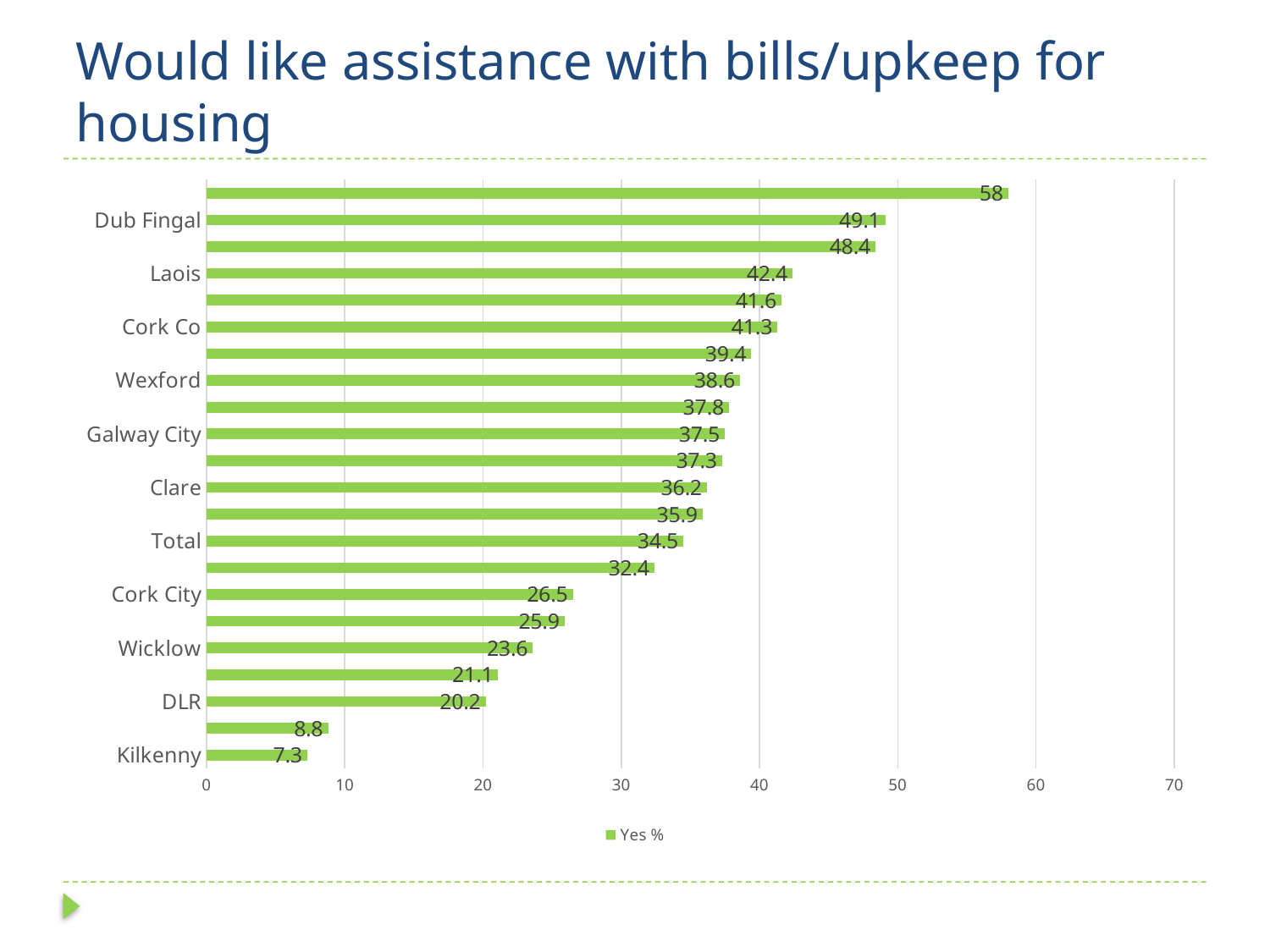
What is the value for Dub Fingal? 49.1 What is the value for Kilkenny? 7.3 Which labelled category has the lowest value? Kilkenny What is the largest value shown on the chart? 58 What is the value for Total? 34.5 What is the difference between the values for Cork Co and Cork City? 14.8 What kind of chart is shown on the slide? bar chart What series does the legend list? Yes % How many bars are plotted on the chart? 22 Which is larger, the value for Wexford or the value for Wicklow? Wexford What is the value for Laois? 42.4 Is the value for DLR greater or less than 30? less